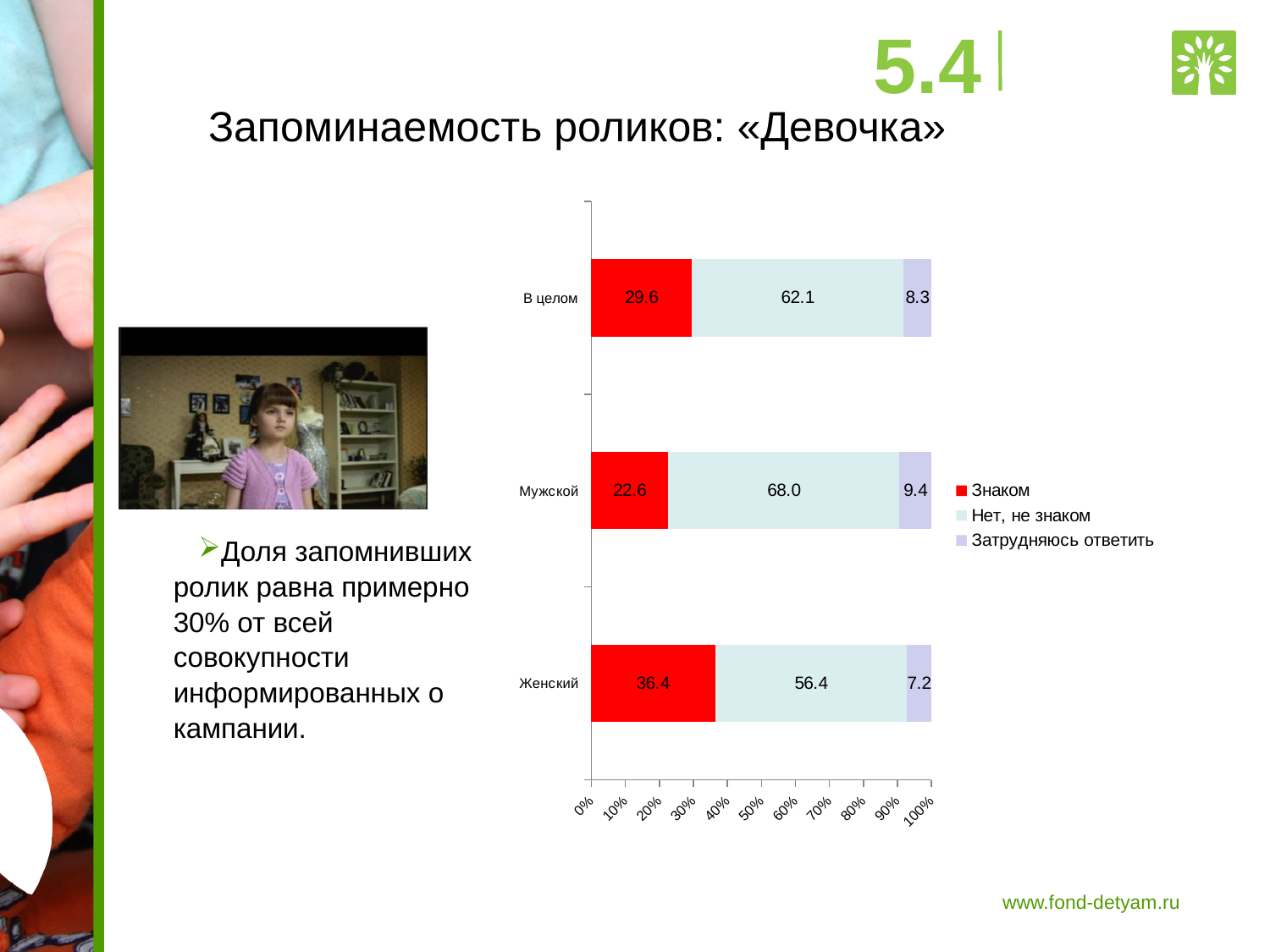
Which colour represents the "Знаком" series? Red How many series does the legend list? 3 What kind of chart is shown on the slide? Stacked bar chart What is the value for "Нет, не знаком" in the "Мужской" category? 68.0 Which category has the highest value for "Знаком"? Женский What is the value for "Затрудняюсь ответить" in the "Женский" category? 7.2 What is the value for "Знаком" in the "В целом" category? 29.6 What is the total of the stacked bar for "Мужской"? 100.0 Which is larger: the "Затрудняюсь ответить" value for "Мужской" or for "В целом"? Мужской How many categories are shown on the chart? 3 Which category has the lowest value for "Нет, не знаком"? Женский What is the difference between the "Знаком" values for "Женский" and "Мужской"? 13.8